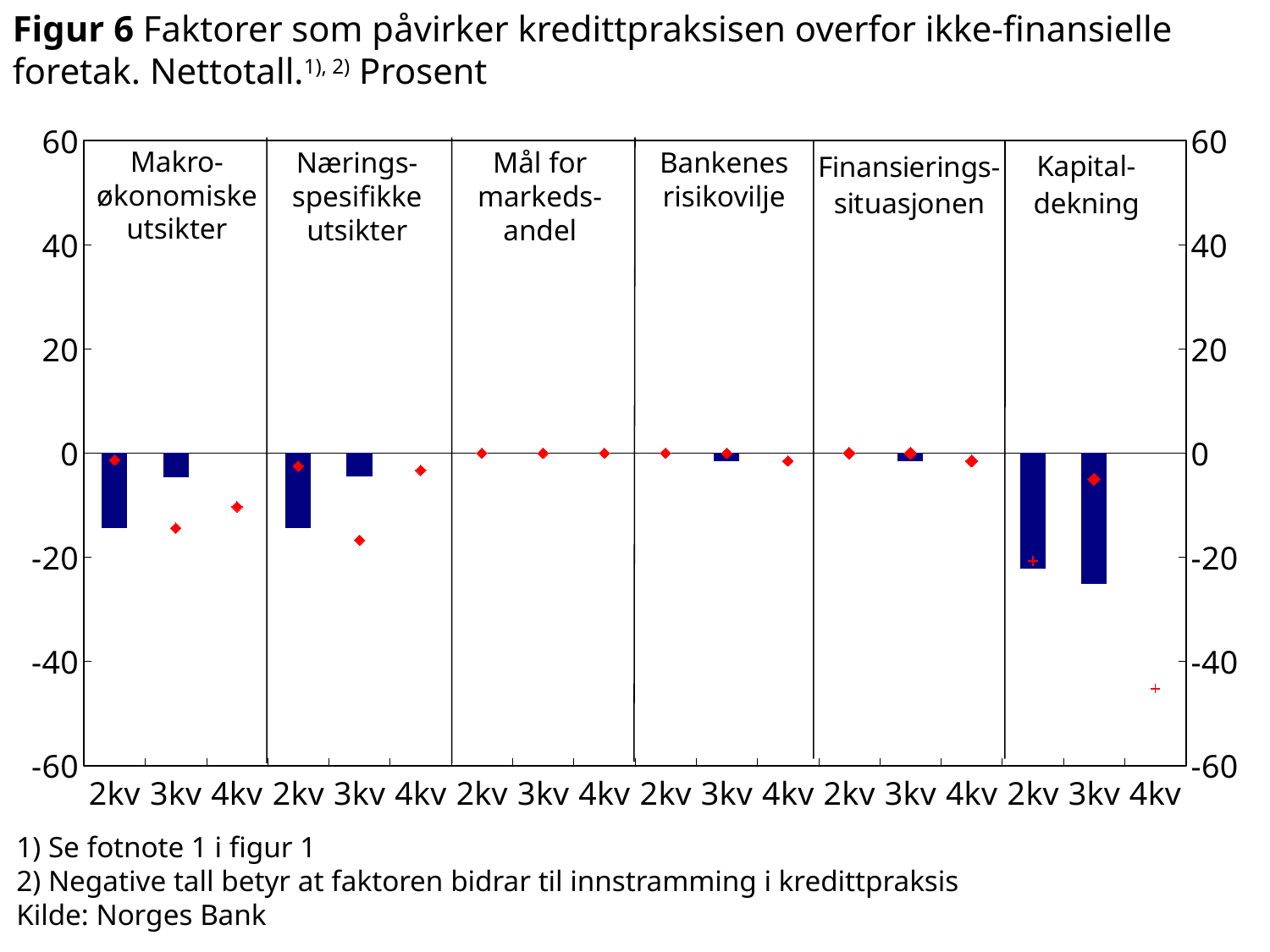
What source is cited for the chart? Norges Bank How many factors (panels) are shown along the x axis of the chart? 6 Which bar is lower: 3kv under Kapitaldekning or 3kv under Makroøkonomiske utsikter? 3kv under Kapitaldekning What kind of chart is shown on the slide? bar chart Which factor shows no visible bars (values at zero) for all quarters? Mål for markedsandel Is the bar for 2kv under Makroøkonomiske utsikter greater or less than -10? less Under Makroøkonomiske utsikter, which bar is lower, 2kv or 3kv? 2kv Is the bar for 3kv under Kapitaldekning greater or less than -20? less Is the bar for 2kv under Næringsspesifikke utsikter greater or less than -10? less How many quarters (2kv, 3kv, 4kv) are shown within each factor panel? 3 Which factor has the lowest (most negative) bar for 3kv? Kapitaldekning